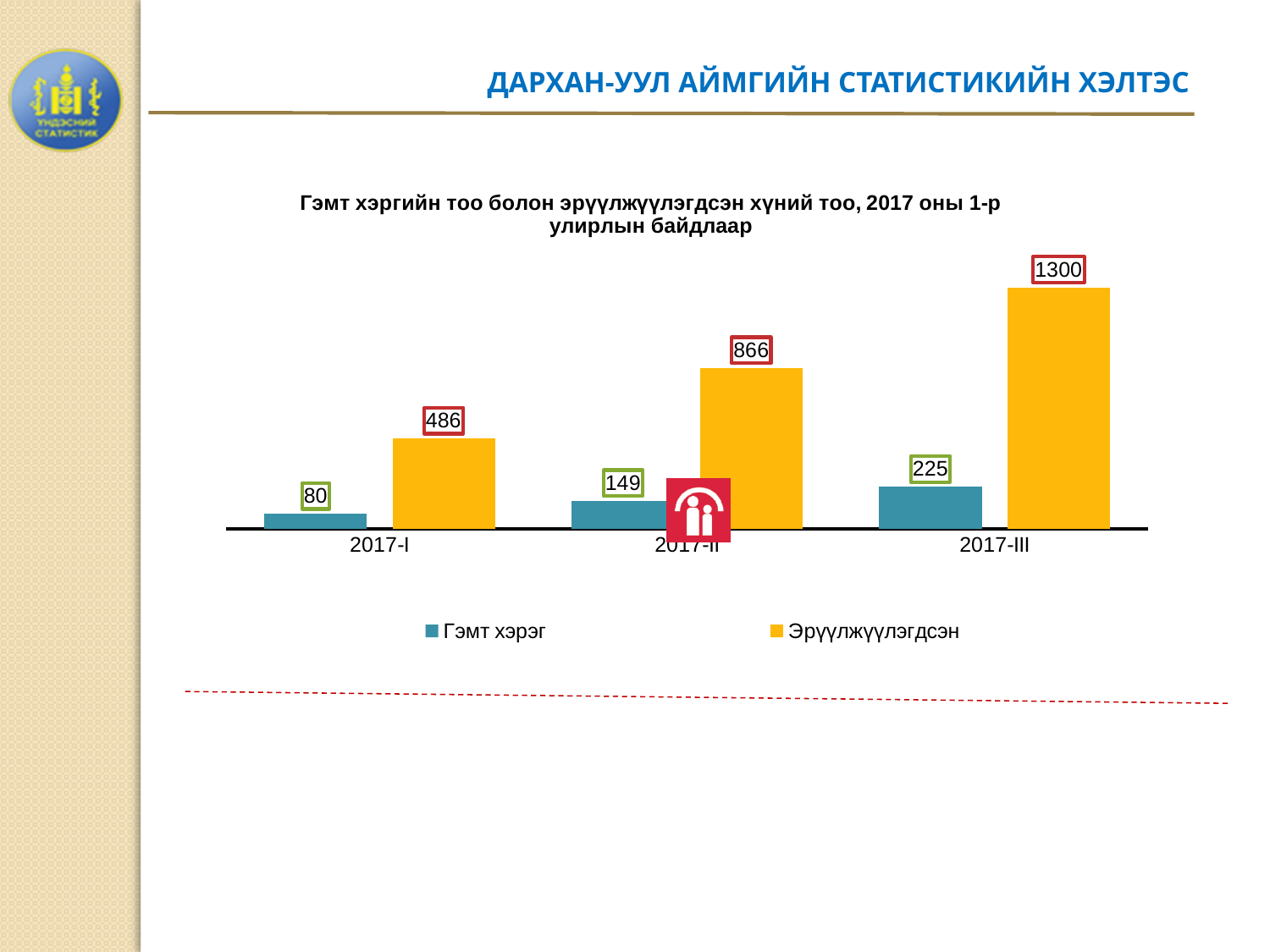
What is the value of Эрүүлжүүлэгдсэн for 2017-III? 1300 What kind of chart is shown on the slide? Bar chart What is the value of Гэмт хэрэг for 2017-III? 225 What is the value of Гэмт хэрэг for 2017-I? 80 How many series does the legend list? 2 What is the difference between the Гэмт хэрэг values for 2017-II and 2017-I? 69 Which is larger: Гэмт хэрэг for 2017-III or Эрүүлжүүлэгдсэн for 2017-I? Эрүүлжүүлэгдсэн for 2017-I What is the difference between the Эрүүлжүүлэгдсэн values for 2017-III and 2017-I? 814 Which period has the highest value for Эрүүлжүүлэгдсэн? 2017-III What is the value of Эрүүлжүүлэгдсэн for 2017-II? 866 Which period has the lowest value for Гэмт хэрэг? 2017-I How many periods are shown on the x axis? 3